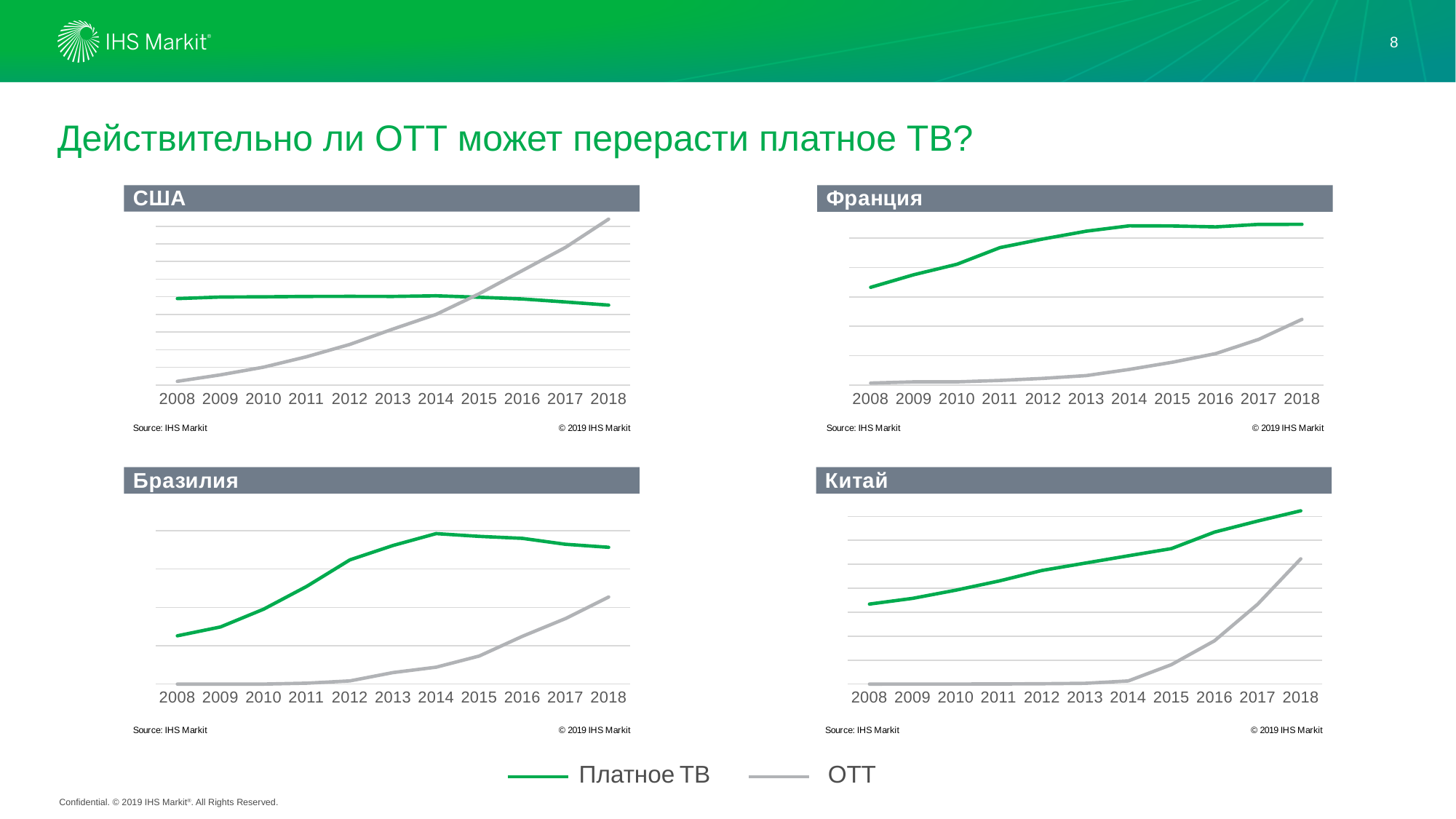
In the США chart, does the ОТТ line rise or fall from 2008 to 2018? rises How many series does the legend at the bottom of the slide list? 2 What colour is the ОТТ line in the charts? grey In the Китай chart, in which year is the ОТТ line at its highest? 2018 What kind of chart is the США chart? line chart In the Франция chart, which series is higher in 2018, Платное ТВ or ОТТ? Платное ТВ In the Бразилия chart, in which year does the Платное ТВ line reach its highest point? 2014 In the США chart, which series is higher in 2018, Платное ТВ or ОТТ? ОТТ What are the two series named in the legend? Платное ТВ and ОТТ In the США chart, which series is higher in 2008, Платное ТВ or ОТТ? Платное ТВ In the Франция chart, does the Платное ТВ line rise or fall from 2008 to 2014? rises How many years are shown on the x axis of the Китай chart? 11